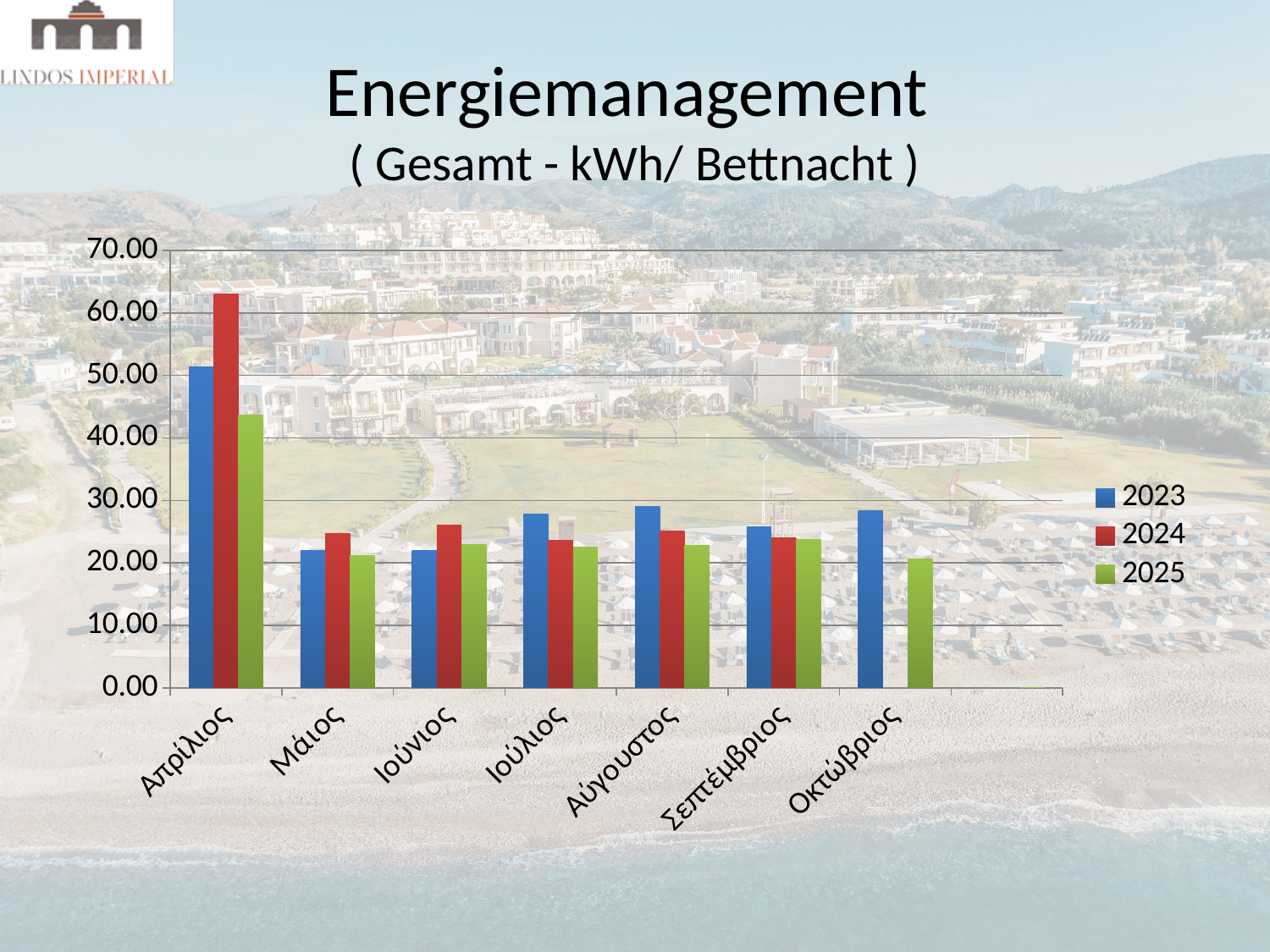
Is the value for Οκτώβριος in 2025 greater or less than 30.00? less Which years are listed in the chart's legend? 2023, 2024, 2025 Is the value for Απρίλιος in 2023 greater or less than 50.00? greater How many months (categories) are shown on the x axis of the chart? 7 What is the title of the chart on the slide? Energiemanagement ( Gesamt - kWh/ Bettnacht ) Is the value for Απρίλιος in 2024 greater or less than 60.00? greater Which month has the highest value for the 2024 series? Απρίλιος For Απρίλιος, which series has the larger value, 2024 or 2025? 2024 How many series does the chart's legend list? 3 For Οκτώβριος, which series has the larger value, 2023 or 2025? 2023 What kind of chart is shown on the slide? bar chart Which month has the highest value for the 2023 series? Απρίλιος